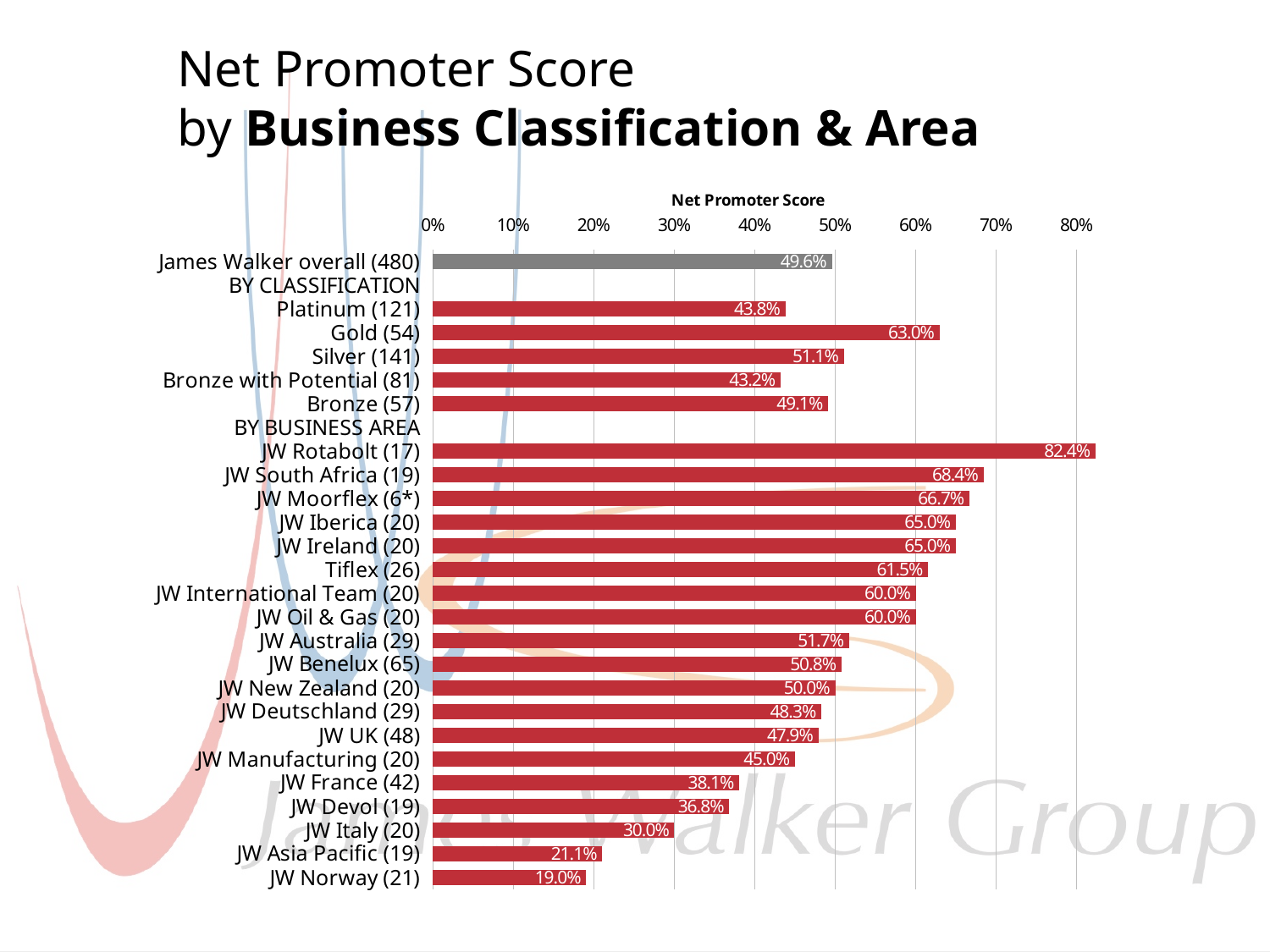
Which has a higher Net Promoter Score, Platinum (121) or Silver (141)? Silver (141) What is the difference between the Net Promoter Score of Gold (54) and James Walker overall (480)? 13.4% What type of chart is shown on the slide? Bar chart Among the classifications (Platinum, Gold, Silver, Bronze with Potential, Bronze), which has the lowest Net Promoter Score? Bronze with Potential (81) What is the difference between the Net Promoter Scores of JW Rotabolt (17) and JW South Africa (19)? 14.0% Which category has the lowest Net Promoter Score on the chart? JW Norway (21) What is the Net Promoter Score for James Walker overall (480)? 49.6% What colour is the bar for James Walker overall (480)? Grey Is the Net Promoter Score for JW Italy (20) greater or less than 40%? less What is the Net Promoter Score for Gold (54)? 63.0% Which business area has the highest Net Promoter Score? JW Rotabolt (17) What is the Net Promoter Score for JW Norway (21)? 19.0%